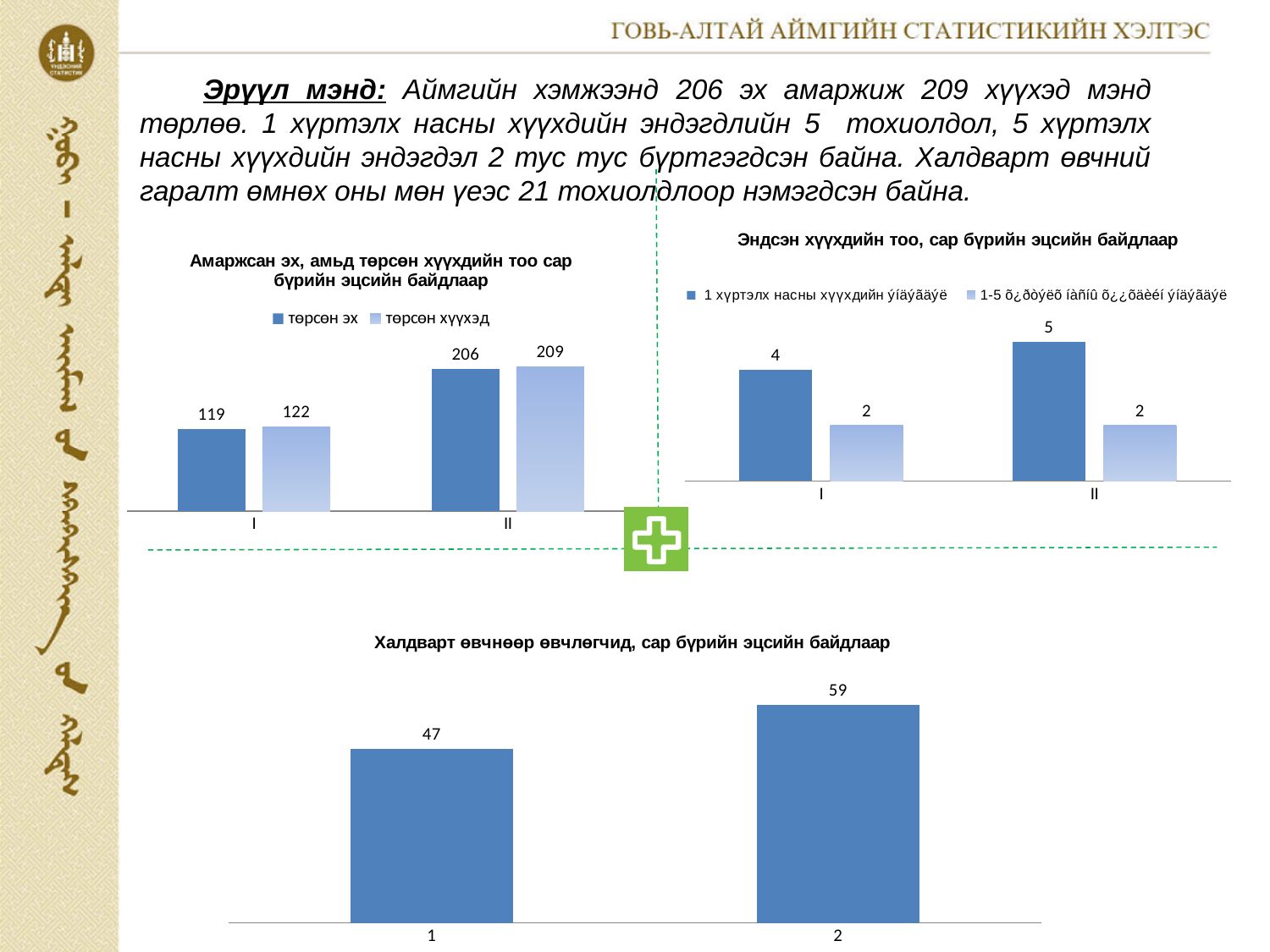
In the chart titled 'Халдварт өвчнөөр өвчлөгчид, сар бүрийн эцсийн байдлаар', what is the difference between the values for category 2 and category 1? 12 In the chart titled 'Халдварт өвчнөөр өвчлөгчид, сар бүрийн эцсийн байдлаар', what is the value for category 2? 59 In the chart titled 'Амаржсан эх, амьд төрсөн хүүхдийн тоо сар бүрийн эцсийн байдлаар', what is the value of 'төрсөн эх' for category II? 206 What type of chart is the one titled 'Халдварт өвчнөөр өвчлөгчид, сар бүрийн эцсийн байдлаар'? bar chart In the chart titled 'Эндсэн хүүхдийн тоо, сар бүрийн эцсийн байдлаар', what is the value of the first (dark blue) series for category II? 5 In the chart titled 'Халдварт өвчнөөр өвчлөгчид, сар бүрийн эцсийн байдлаар', how many categories are shown on the x axis? 2 In the chart titled 'Амаржсан эх, амьд төрсөн хүүхдийн тоо сар бүрийн эцсийн байдлаар', does the value of 'төрсөн эх' rise or fall from category I to category II? rise In the chart titled 'Эндсэн хүүхдийн тоо, сар бүрийн эцсийн байдлаар', which category has the higher value for the dark blue series, I or II? II In the chart titled 'Эндсэн хүүхдийн тоо, сар бүрийн эцсийн байдлаар', what is the value of the second (light blue) series for category I? 2 In the chart titled 'Амаржсан эх, амьд төрсөн хүүхдийн тоо сар бүрийн эцсийн байдлаар', what is the value of 'төрсөн хүүхэд' for category I? 122 In the chart titled 'Амаржсан эх, амьд төрсөн хүүхдийн тоо сар бүрийн эцсийн байдлаар', what is the difference between 'төрсөн хүүхэд' and 'төрсөн эх' for category II? 3 In the chart titled 'Амаржсан эх, амьд төрсөн хүүхдийн тоо сар бүрийн эцсийн байдлаар', how many series does the legend list? 2